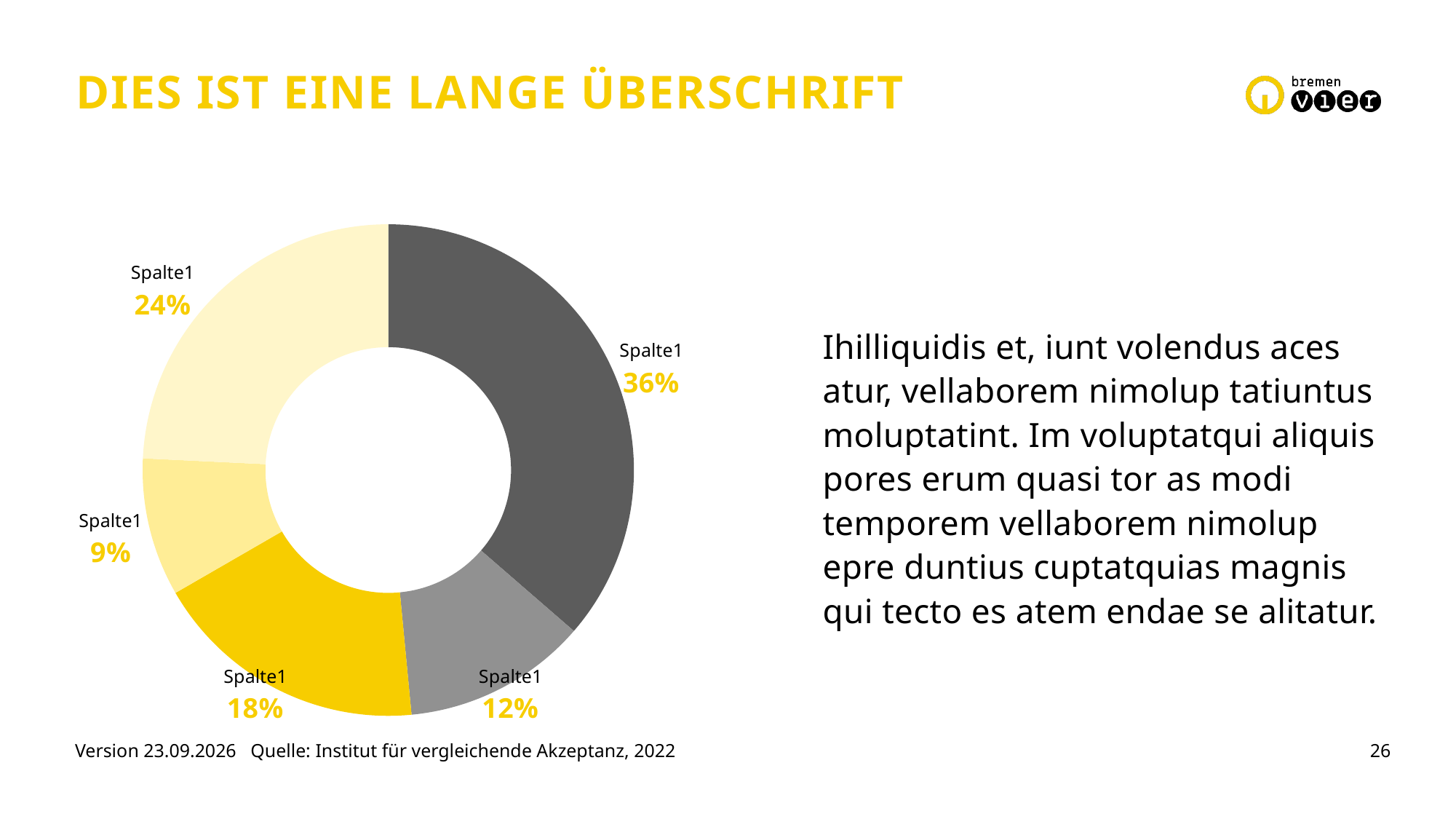
What percentage is shown for the light grey slice of the doughnut chart? 12% How many slices does the doughnut chart have? 5 Which is larger: the slice labelled 24% or the slice labelled 18%? the slice labelled 24% What kind of chart is shown on the slide? doughnut (pie) chart What is the largest percentage shown on the doughnut chart? 36% What category label is shown next to every slice of the doughnut chart? Spalte1 What is the difference between the dark grey slice (36%) and the light grey slice (12%)? 24 percentage points What source is cited below the chart? Institut für vergleichende Akzeptanz, 2022 What percentage is shown for the bright yellow slice at the bottom left of the doughnut chart? 18% What is the smallest percentage shown on the doughnut chart? 9% What is the difference between the 24% slice and the 9% slice? 15 percentage points What percentage is shown for the dark grey slice of the doughnut chart? 36%